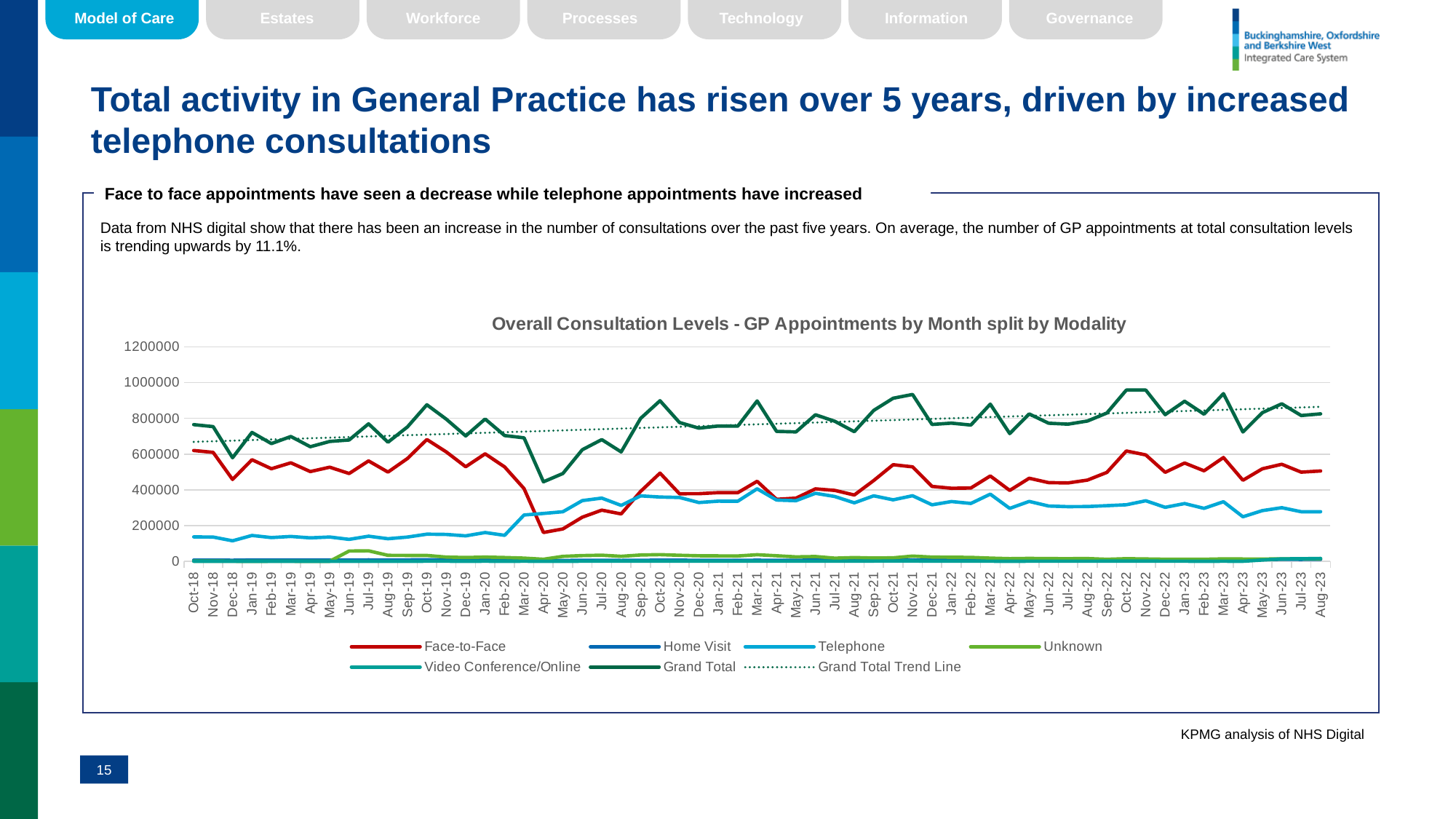
In Apr-20, which is larger: Telephone or Face-to-Face? Telephone How many series does the chart legend list? 7 Is the Grand Total value for Oct-22 greater or less than 800000? greater In Oct-18, which is larger: Face-to-Face or Telephone? Face-to-Face Is the Face-to-Face value for Apr-20 greater or less than 200000? less What kind of chart is shown on the slide? Line chart What is the title of the chart? Overall Consultation Levels - GP Appointments by Month split by Modality Is the Telephone value for Oct-18 greater or less than 200000? less Does the Telephone series rise or fall overall from Oct-18 to Aug-23? Rise Which series is drawn as a dotted line in the chart? Grand Total Trend Line